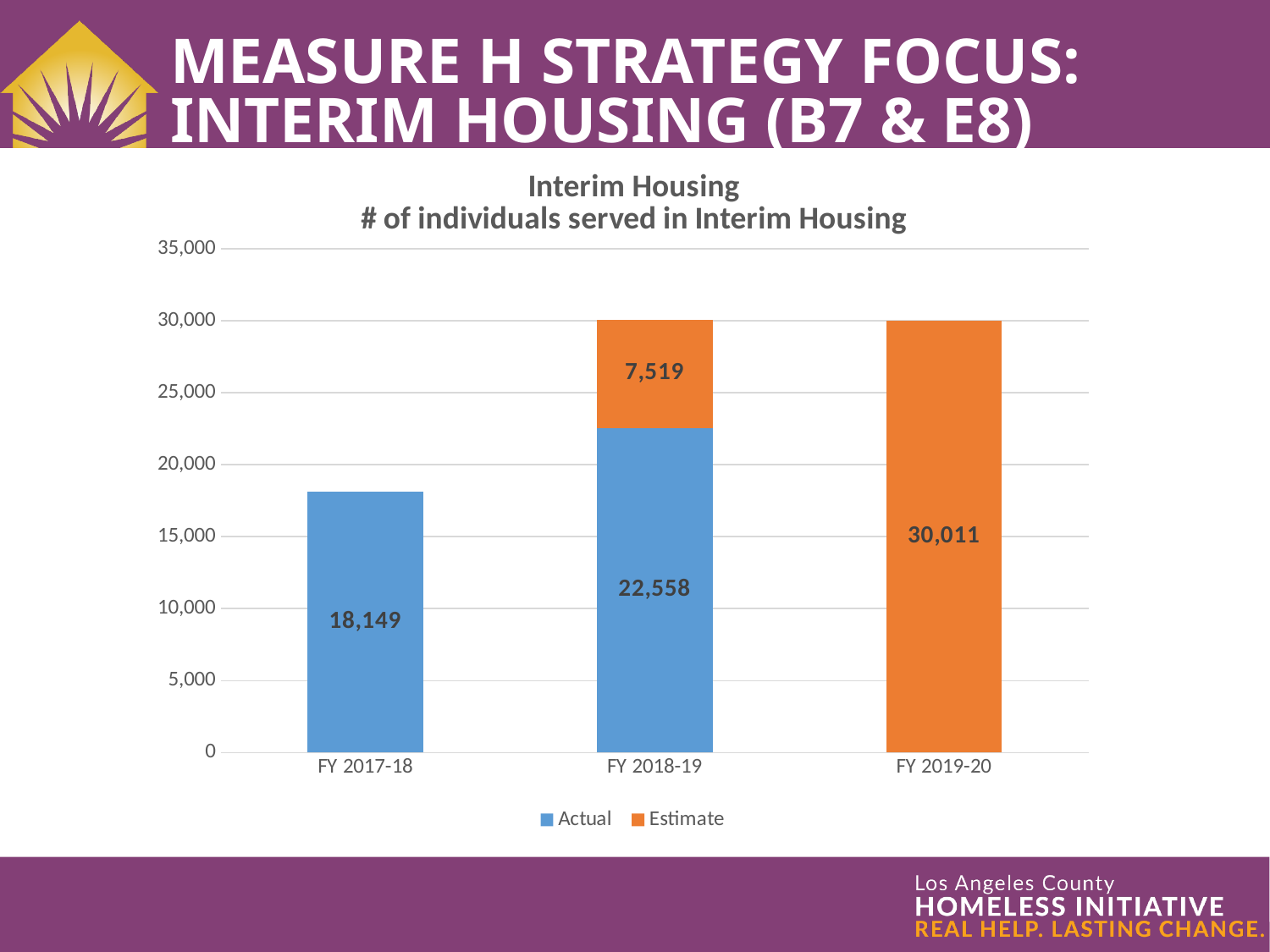
What kind of chart is shown on the slide? Stacked bar chart What is the difference between the Actual values for FY 2018-19 and FY 2017-18? 4,409 How many series does the legend list? 2 Which is larger, the Actual value for FY 2018-19 or the Estimate value for FY 2019-20? Estimate value for FY 2019-20 How many fiscal years are shown on the x axis? 3 What is the Actual value for FY 2018-19? 22,558 What is the Estimate value for FY 2019-20? 30,011 What is the Actual value for FY 2017-18? 18,149 What is the total of the stacked bar for FY 2018-19? 30,077 Which fiscal year has the lowest Actual value? FY 2017-18 Is the Actual value for FY 2017-18 greater or less than 20,000? less What is the Estimate value for FY 2018-19? 7,519